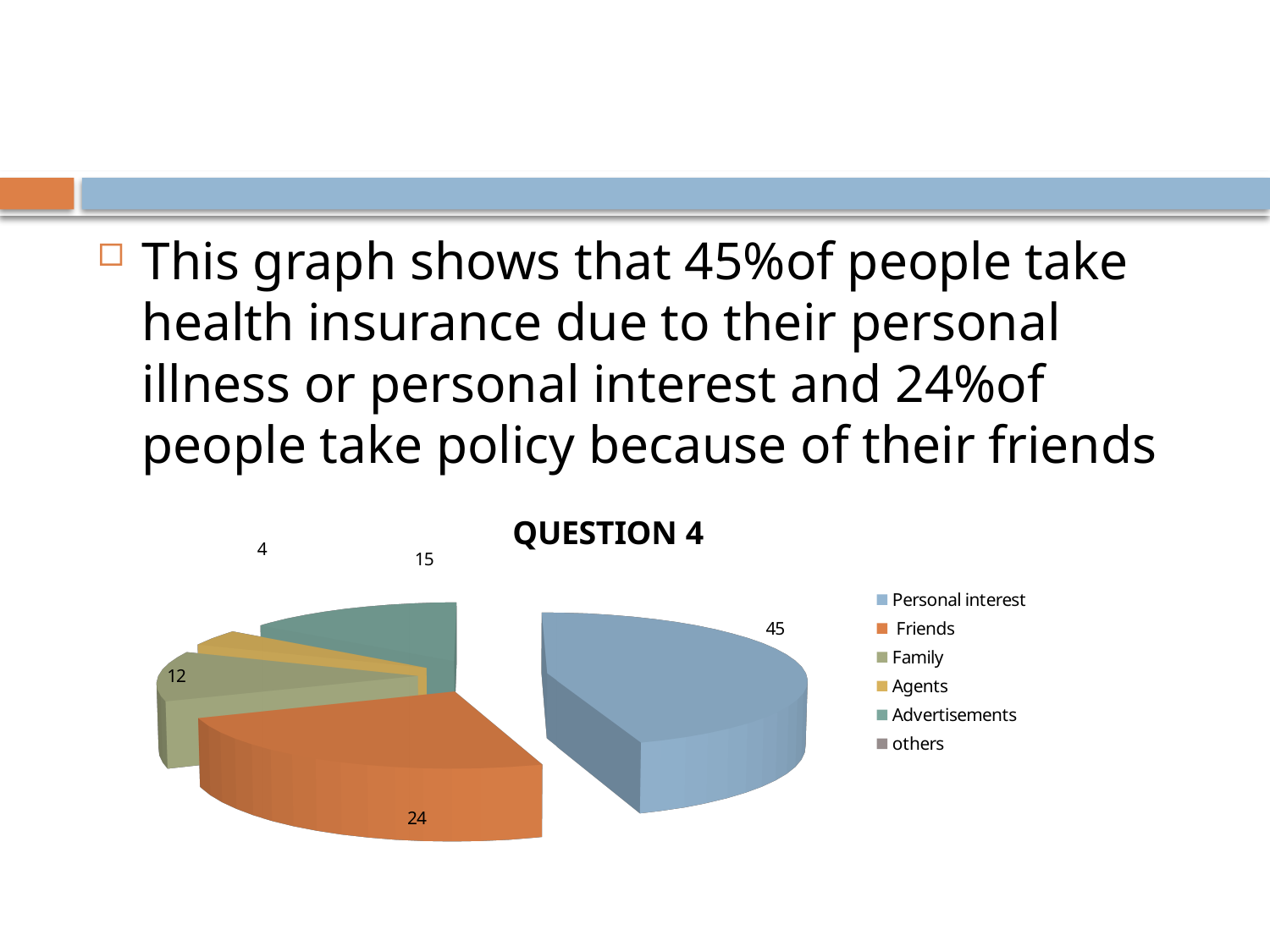
Which labelled slice of the pie has the smallest value? Agents What is the difference between the values for Personal interest and Friends? 21 What is the value for Advertisements in the pie chart? 15 What is the title of the chart? QUESTION 4 How many categories does the legend list? 6 Which category has the largest slice of the pie? Personal interest What is the value for Personal interest in the pie chart? 45 What is the value for Agents in the pie chart? 4 What is the value for Friends in the pie chart? 24 What is the value for Family in the pie chart? 12 Which is larger, the value for Advertisements or the value for Family? Advertisements What type of chart is shown on the slide? Pie chart